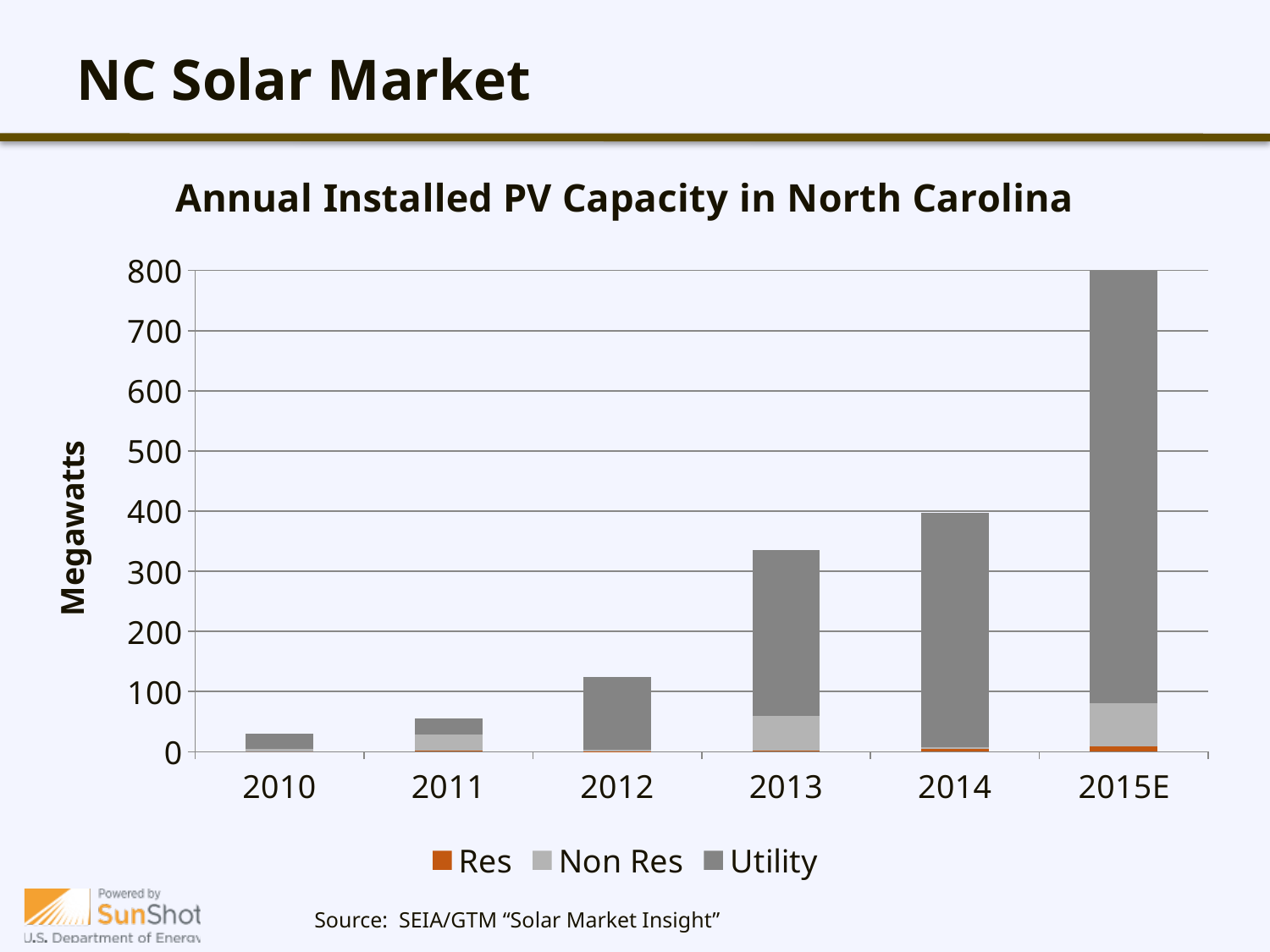
What kind of chart is shown on the slide? stacked bar chart Is the total value for 2015E greater or less than 700? greater What is the title of the chart? Annual Installed PV Capacity in North Carolina Is the total value for 2012 greater or less than 200? less Do the total bar heights rise or fall from 2010 to 2015E? rise How many years are shown along the x axis? 6 What is the label on the y axis? Megawatts Which year has the highest total installed PV capacity? 2015E Which year has the lowest total installed PV capacity? 2010 Which year has the larger total installed capacity, 2011 or 2014? 2014 Is the total value for 2013 greater or less than 300? greater How many series does the legend list? 3